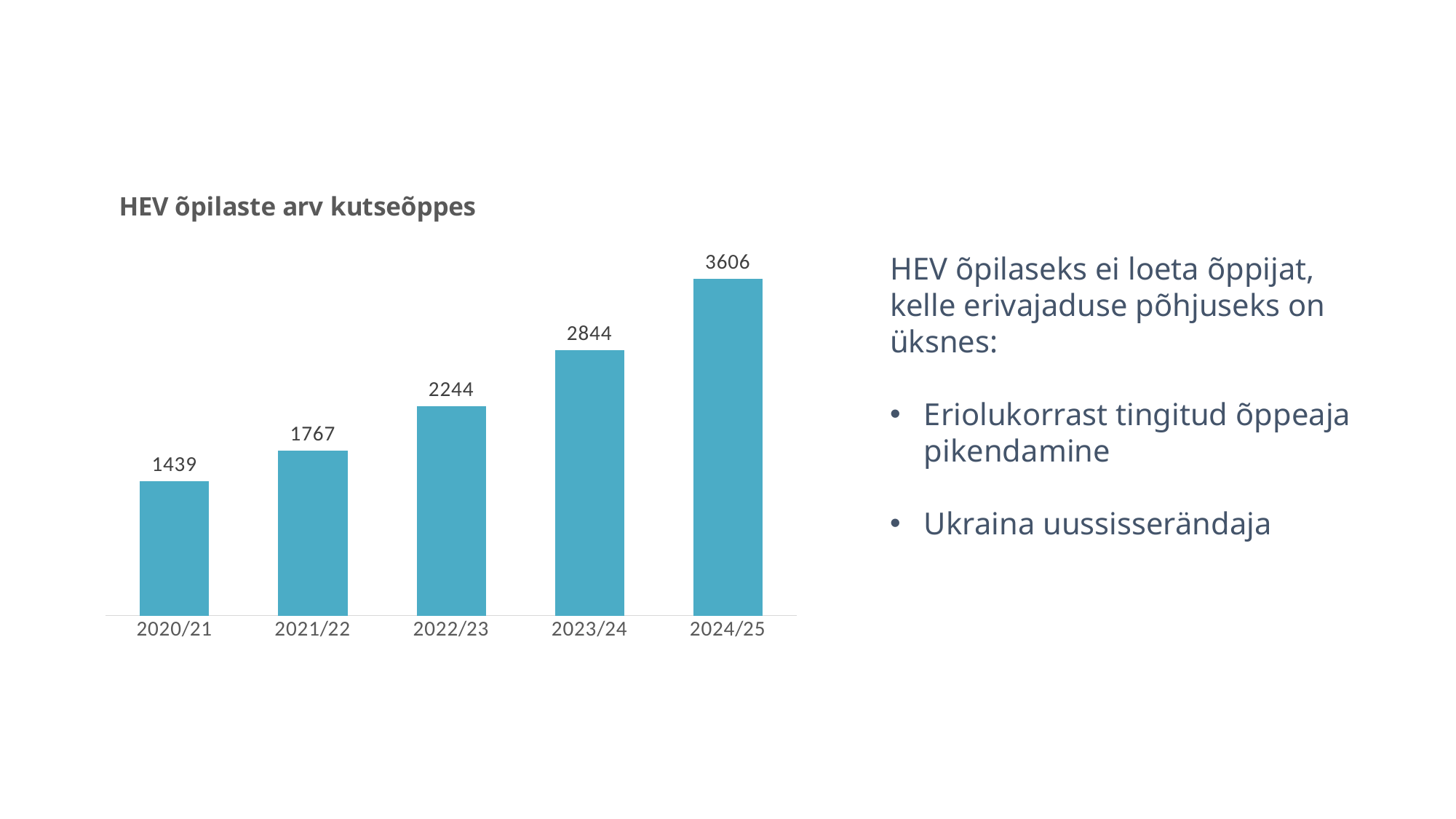
Which year has the highest value? 2024/25 What is the difference between the values for 2024/25 and 2023/24? 762 Which year has the lowest value? 2020/21 Do the values rise or fall from 2020/21 to 2024/25? rise What is the title of the chart? HEV õpilaste arv kutseõppes What is the difference between the values for 2021/22 and 2020/21? 328 What is the value for 2020/21? 1439 What is the value for 2022/23? 2244 Which is larger, the value for 2022/23 or the value for 2021/22? 2022/23 How many years are shown on the x axis? 5 What is the value for 2024/25? 3606 What kind of chart is shown on the slide? bar chart